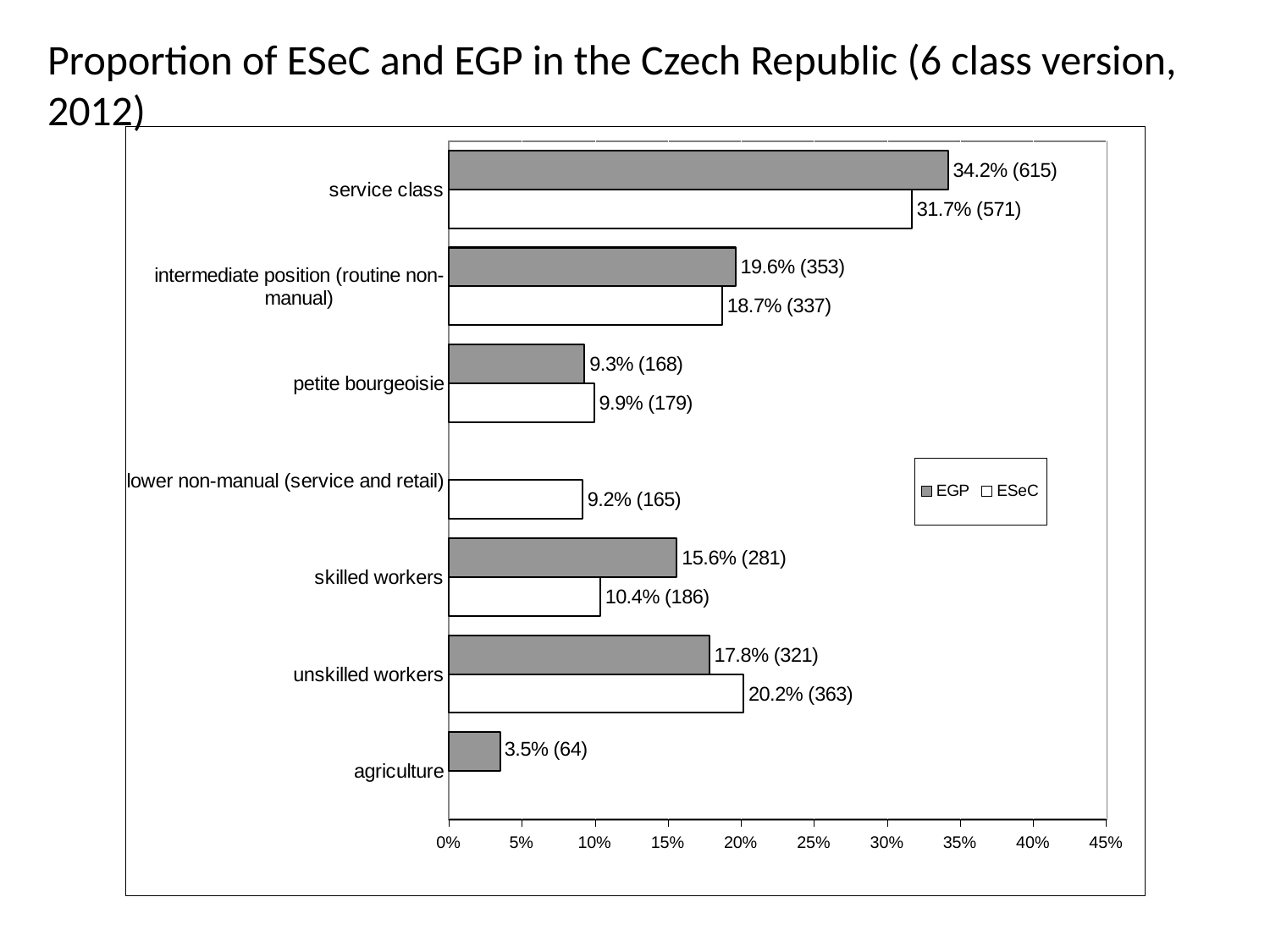
What is the ESeC value for unskilled workers? 20.2% (363) Which category has the highest EGP value? service class How many series does the legend list? 2 Which category has the lowest ESeC value? lower non-manual (service and retail) What is the ESeC value for lower non-manual (service and retail)? 9.2% (165) Which series is shown with grey bars? EGP For unskilled workers, which is larger, the EGP value or the ESeC value? ESeC What is the difference in percentage points between the EGP and ESeC values for skilled workers? 5.2 How many categories are shown on the y axis? 7 What is the EGP value for service class? 34.2% (615) What is the EGP value for agriculture? 3.5% (64) What kind of chart is shown on the slide? bar chart